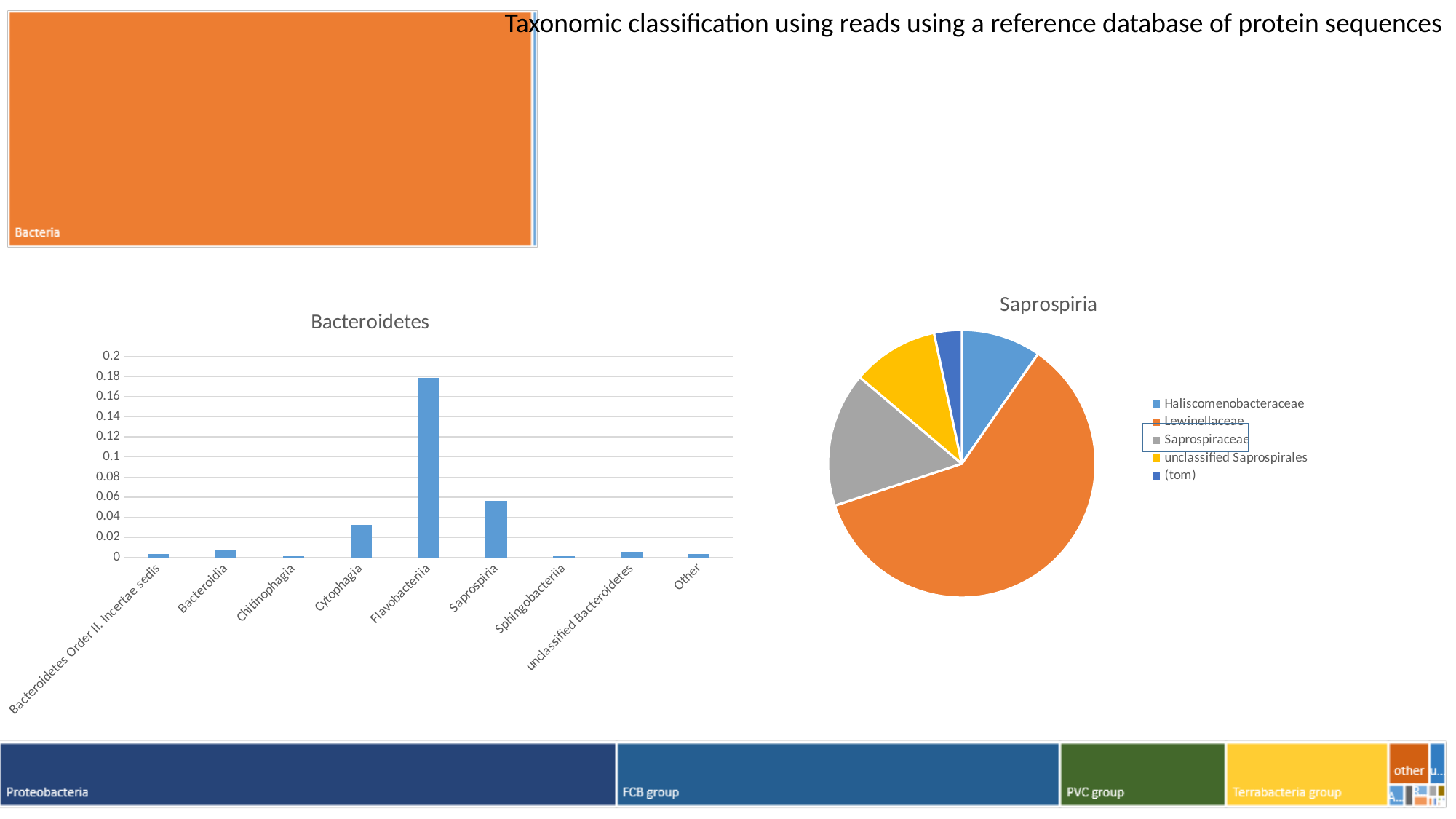
In the Bacteroidetes chart, which category has the highest value? Flavobacteriia In the Bacteroidetes chart, which is larger, the value for Saprospiria or the value for Cytophagia? Saprospiria In the Saprospiria pie chart, which is larger, the Saprospiraceae slice or the unclassified Saprospirales slice? Saprospiraceae What kind of chart is the Saprospiria chart? pie chart In the Saprospiria pie chart, which slice is the largest? Lewinellaceae In the Bacteroidetes chart, is the value for Flavobacteriia greater or less than 0.16? greater In the Saprospiria pie chart, which slice is the smallest? (tom) In the Bacteroidetes chart, is the value for Cytophagia greater or less than 0.02? greater What kind of chart is the Bacteroidetes chart? bar chart In the Saprospiria pie chart, how many entries does the legend list? 5 In the Bacteroidetes chart, how many categories are shown on the x axis? 9 In the Bacteroidetes chart, is the value for Saprospiria greater or less than 0.08? less